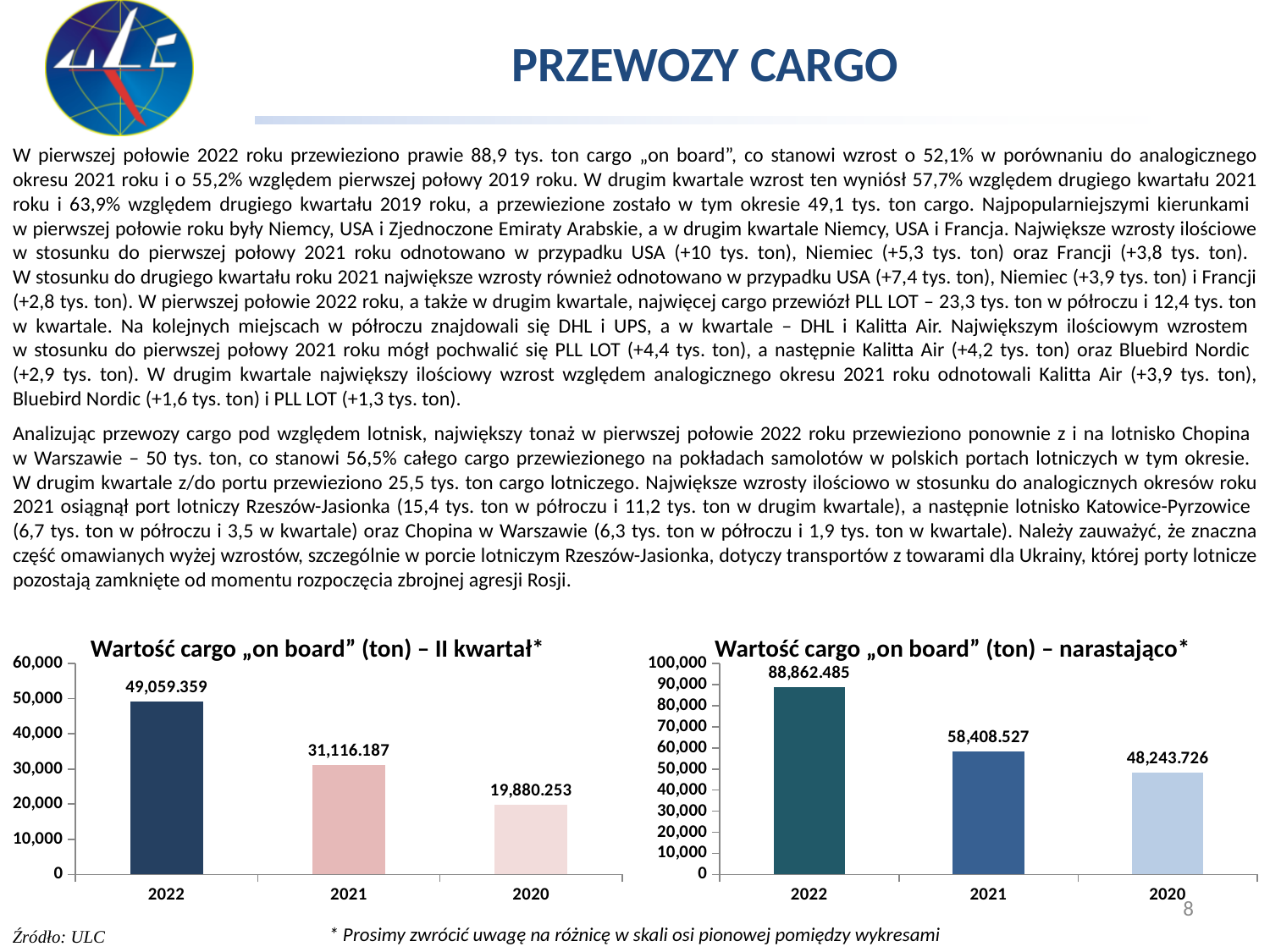
In the chart titled "Wartość cargo „on board” (ton) – II kwartał*", which year has the highest value? 2022 In the chart titled "Wartość cargo „on board” (ton) – narastająco*", what is the value for 2022? 88,862.485 What kind of chart is the chart titled "Wartość cargo „on board” (ton) – narastająco*"? Bar chart In the chart titled "Wartość cargo „on board” (ton) – narastająco*", is the value for 2021 larger than the value for 2020? Yes In the chart titled "Wartość cargo „on board” (ton) – II kwartał*", how many years are shown on the x axis? 3 In the chart titled "Wartość cargo „on board” (ton) – II kwartał*", what is the difference between the values for 2022 and 2021? 17,943.172 In the chart titled "Wartość cargo „on board” (ton) – narastająco*", which year has the lowest value? 2020 In the chart titled "Wartość cargo „on board” (ton) – II kwartał*", what is the value for 2020? 19,880.253 In the chart titled "Wartość cargo „on board” (ton) – narastająco*", what is the value for 2021? 58,408.527 In the chart titled "Wartość cargo „on board” (ton) – II kwartał*", what is the value for 2022? 49,059.359 In the chart titled "Wartość cargo „on board” (ton) – II kwartał*", do the values rise or fall from left to right along the x axis? Fall In the chart titled "Wartość cargo „on board” (ton) – narastająco*", what is the difference between the values for 2021 and 2020? 10,164.801